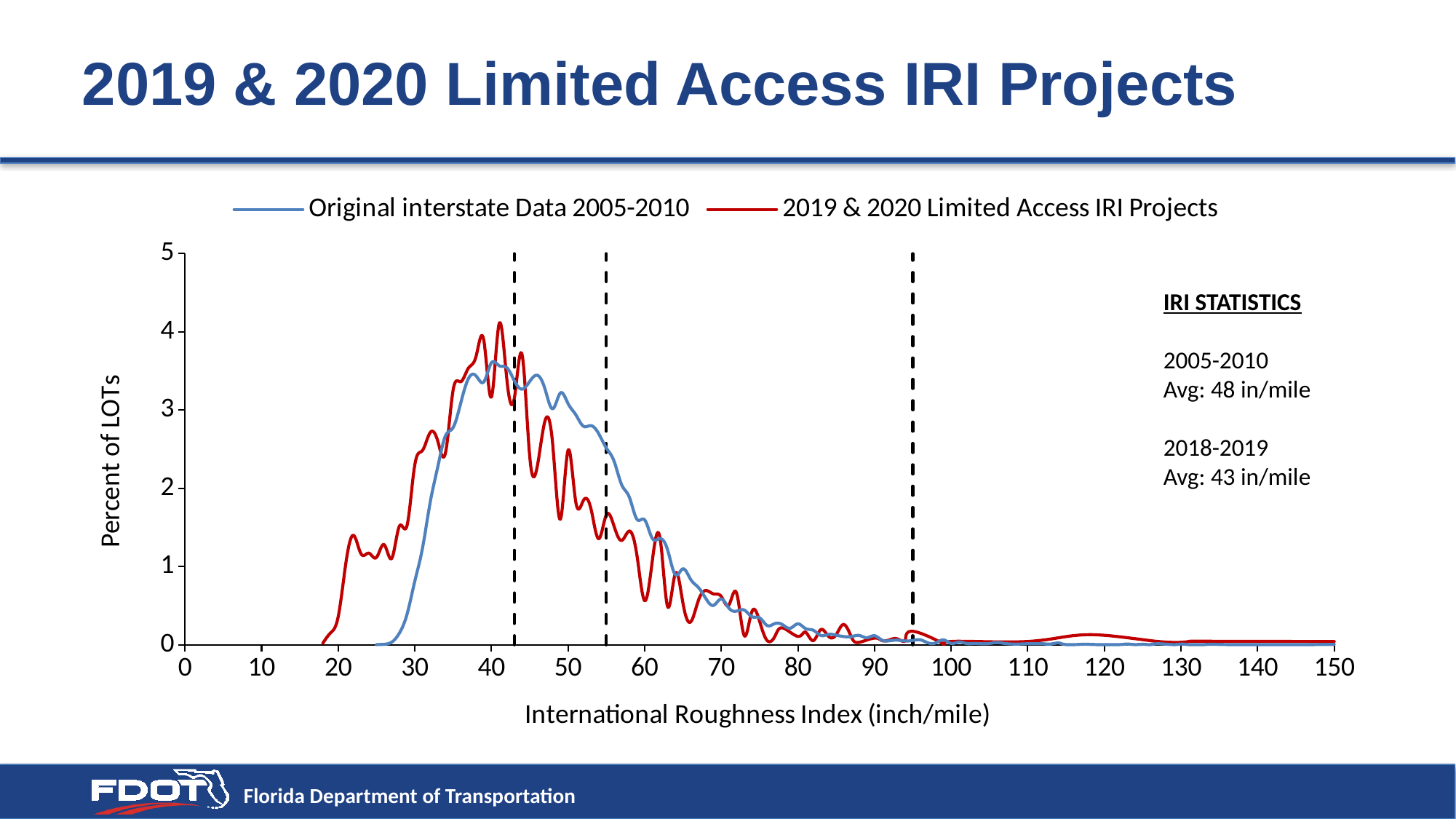
How many series does the legend list? 2 Is the value of the 2019 & 2020 Limited Access IRI Projects series at an IRI of 100 greater or less than 1? less Is the value of the Original interstate Data 2005-2010 series at an IRI of 30 greater or less than 1? less Is the value of the 2019 & 2020 Limited Access IRI Projects series at an IRI of 40 greater or less than 3? greater At an IRI of 30, which series has the higher value? 2019 & 2020 Limited Access IRI Projects Which series reaches the higher peak value? 2019 & 2020 Limited Access IRI Projects At an IRI of 50, which series has the higher value? Original interstate Data 2005-2010 What kind of chart is shown on the slide? Line chart What is the title of the x axis? International Roughness Index (inch/mile) Which series is drawn in red? 2019 & 2020 Limited Access IRI Projects Between an IRI of 60 and 90, do the values of the Original interstate Data 2005-2010 series rise or fall? fall